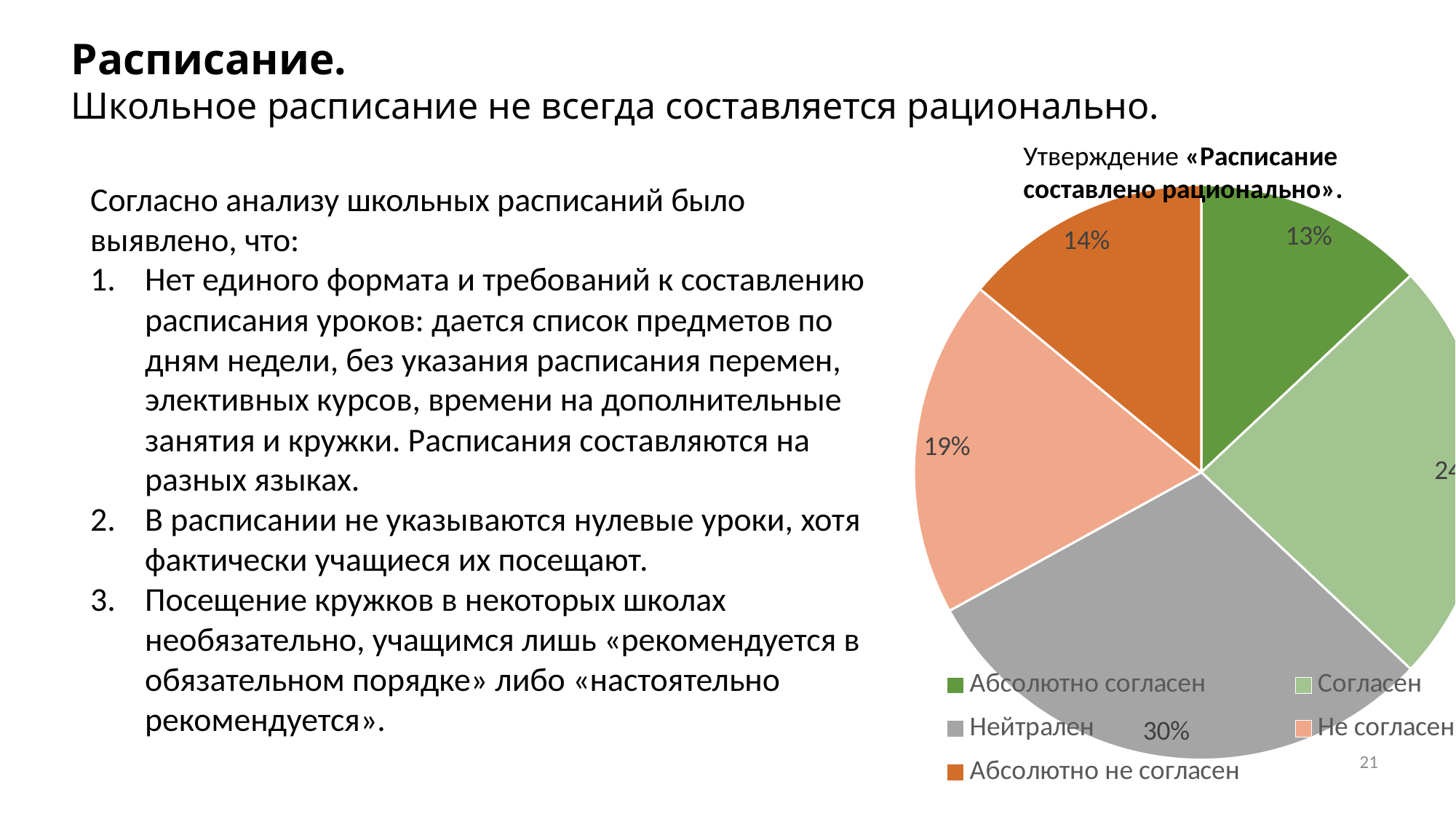
What colour is the «Нейтрален» slice? grey How many response categories does the legend list? 5 What share of respondents answered «Не согласен»? 19% Which response category has the smallest share of the pie? Абсолютно согласен What share of respondents answered «Нейтрален»? 30% Which response category has the largest share of the pie? Нейтрален What is the difference in percentage points between «Нейтрален» and «Не согласен»? 11 Which is larger: the share for «Не согласен» or the share for «Абсолютно не согласен»? Не согласен What share of respondents answered «Абсолютно не согласен»? 14% What is the combined share of «Абсолютно согласен» and «Абсолютно не согласен»? 27% What kind of chart is shown on the slide? pie chart What share of respondents answered «Абсолютно согласен»? 13%